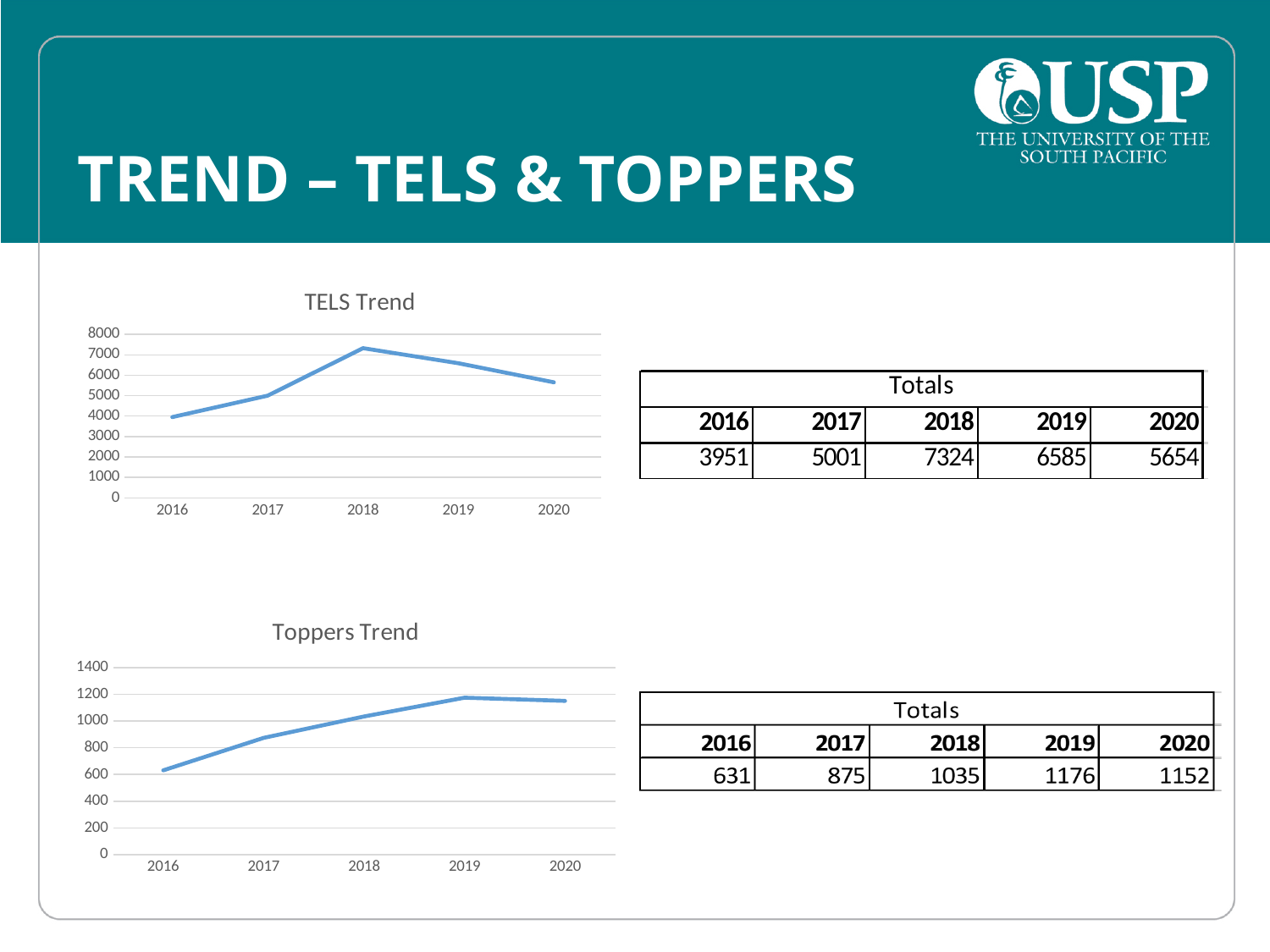
In the TELS Trend chart, what is the difference between the 2018 and 2016 values? 3373 In the Toppers Trend chart, do the values rise or fall from 2016 to 2019? rise In the TELS Trend chart, which year has the highest value? 2018 In the Toppers Trend chart, is the value for 2018 greater or less than 1000? greater In the TELS Trend chart, which is larger, the value for 2019 or the value for 2020? 2019 What is the title of the upper chart on the slide? TELS Trend In the Toppers Trend chart, what is the value for 2016? 631 In the TELS Trend chart, what is the value for 2018? 7324 How many years are plotted in the TELS Trend chart? 5 What kind of chart is the Toppers Trend chart? line chart In the Toppers Trend chart, what is the difference between the 2019 and 2020 values? 24 In the Toppers Trend chart, which year has the lowest value? 2016